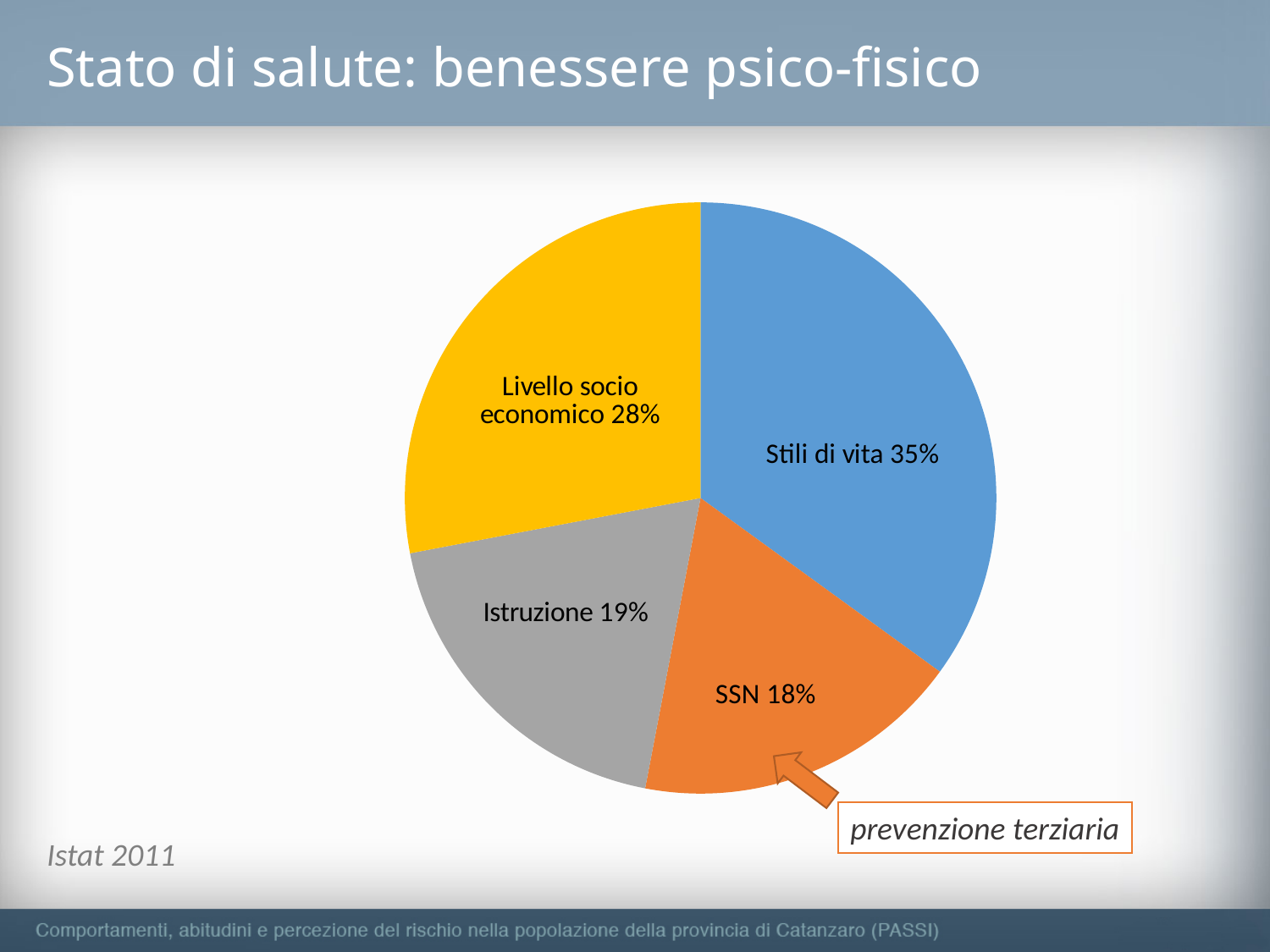
What kind of chart is shown on the slide? Pie chart What percentage does the pie chart show for Livello socio economico? 28% Which slice of the pie chart is the largest? Stili di vita What percentage does the pie chart show for Stili di vita? 35% How many slices does the pie chart have? 4 What percentage does the pie chart show for SSN? 18% What is the difference in percentage points between Stili di vita and Livello socio economico? 7 What is the difference in percentage points between Istruzione and SSN? 1 Which is larger, Livello socio economico or Istruzione? Livello socio economico What percentage does the pie chart show for Istruzione? 19% What colour is the SSN slice of the pie chart? Orange Which slice of the pie chart is the smallest? SSN